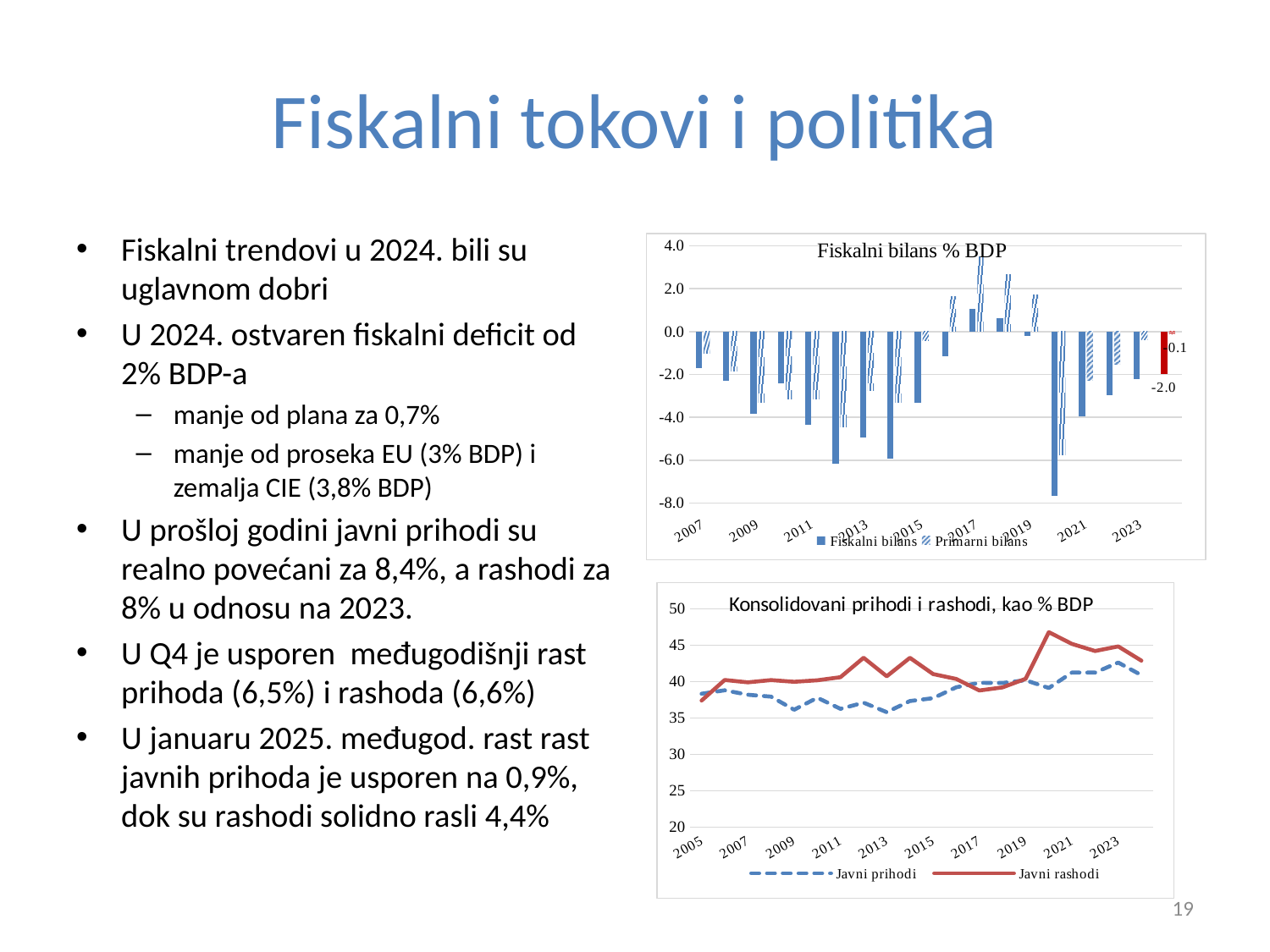
In the chart "Fiskalni bilans % BDP", in which year is Fiskalni bilans at its lowest? 2020 In the chart "Konsolidovani prihodi i rashodi, kao % BDP", which series is higher in 2020, Javni prihodi or Javni rashodi? Javni rashodi In the chart "Fiskalni bilans % BDP", how many series does the legend list? 2 In the chart "Konsolidovani prihodi i rashodi, kao % BDP", how many series does the legend list? 2 In the chart "Fiskalni bilans % BDP", what is the labelled value of Fiskalni bilans for 2024? -2.0 In the chart "Konsolidovani prihodi i rashodi, kao % BDP", is the Javni rashodi value for 2020 greater or less than 45? greater In the chart "Konsolidovani prihodi i rashodi, kao % BDP", which series is drawn with a dashed line? Javni prihodi What kind of chart is the chart titled "Konsolidovani prihodi i rashodi, kao % BDP"? line chart In the chart "Fiskalni bilans % BDP", what is the labelled value of Primarni bilans for 2024? -0.1 In the chart "Konsolidovani prihodi i rashodi, kao % BDP", in which year does Javni rashodi reach its highest value? 2020 In the chart "Fiskalni bilans % BDP", is the Fiskalni bilans value for 2020 greater or less than -6.0? less What kind of chart is the chart titled "Fiskalni bilans % BDP"? bar chart